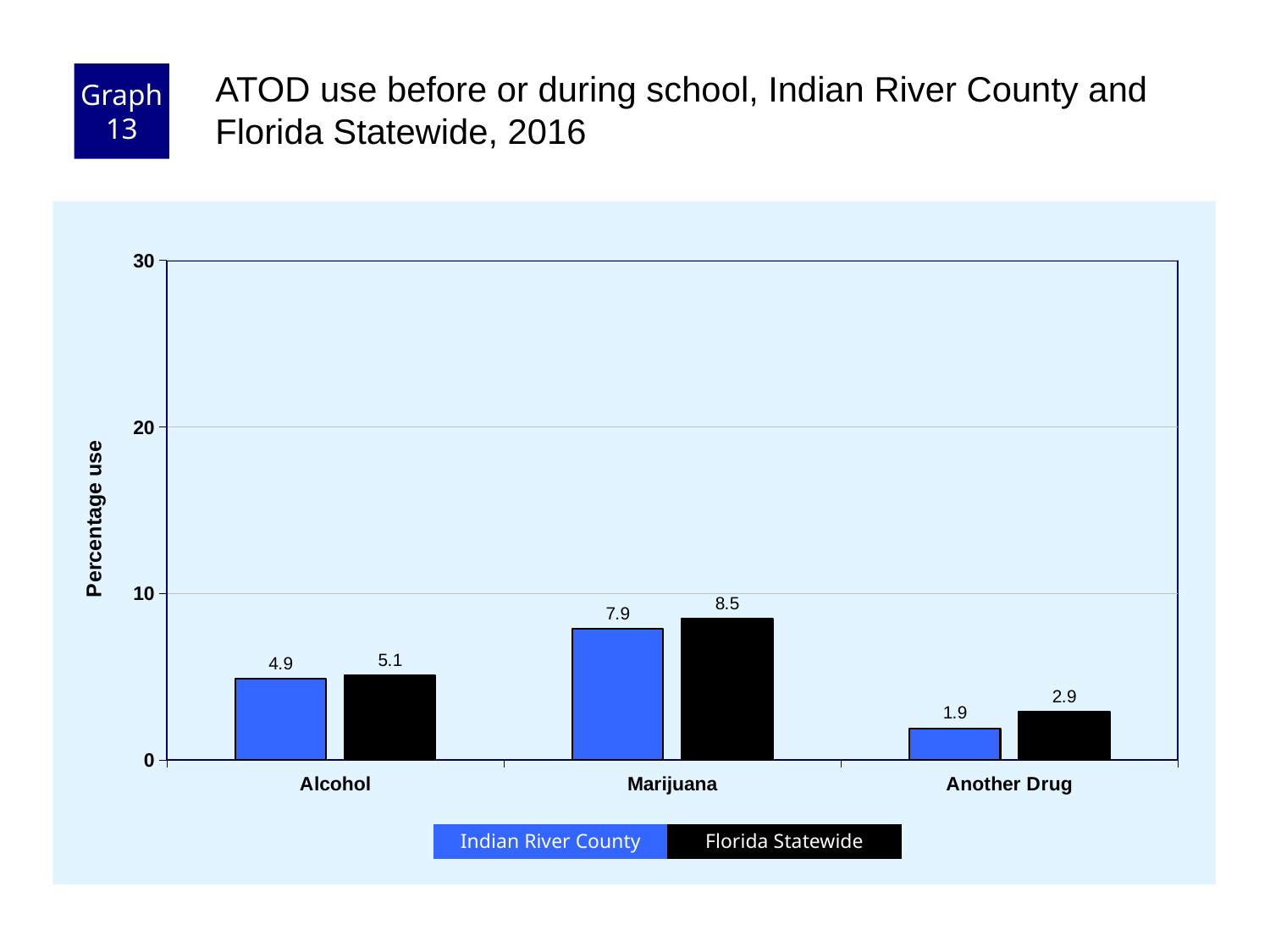
Which is larger for Alcohol: Indian River County or Florida Statewide? Florida Statewide What is the Indian River County value for Marijuana? 7.9 Which category has the highest Florida Statewide value? Marijuana Which category has the lowest Indian River County value? Another Drug What is the difference between the Florida Statewide and Indian River County values for Another Drug? 1.0 How many categories are shown on the x axis? 3 Is the Florida Statewide value for Marijuana greater or less than 10? less What kind of chart is shown on the slide? bar chart What is the Florida Statewide value for Another Drug? 2.9 How many series does the legend list? 2 What is the difference between the Florida Statewide and Indian River County values for Marijuana? 0.6 What is the Indian River County value for Alcohol? 4.9